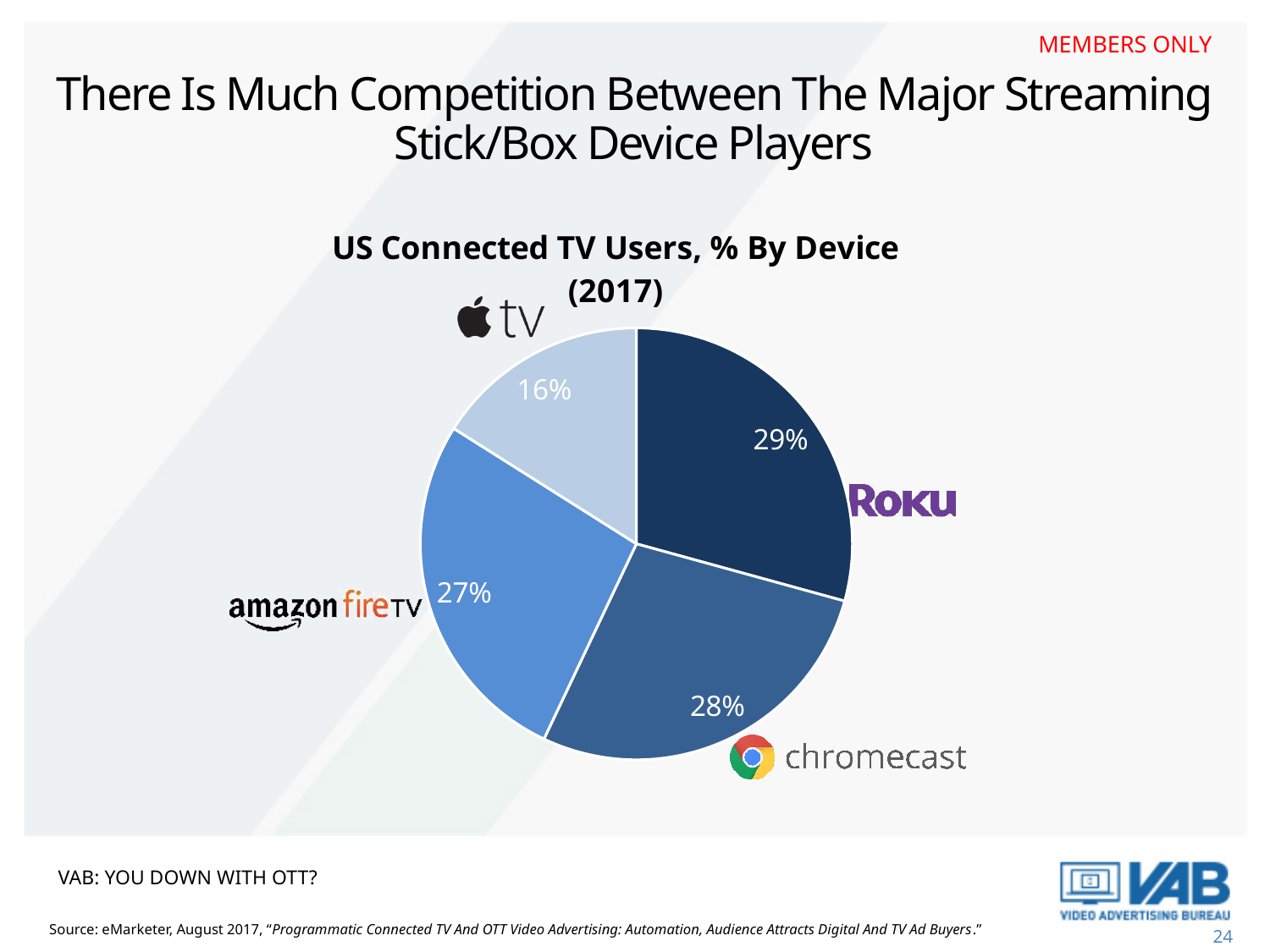
What share of US connected TV users does Apple TV have? 16% What share of US connected TV users does Amazon Fire TV have? 27% What share of US connected TV users does Roku have? 29% What kind of chart is shown on the slide? pie chart What is the title of the chart? US Connected TV Users, % By Device (2017) How many devices are shown in the pie chart? 4 Which device has the smallest share of US connected TV users? Apple TV Which device has the largest share of US connected TV users? Roku What share of US connected TV users does Chromecast have? 28% Which has a larger share, Amazon Fire TV or Apple TV? Amazon Fire TV What is the difference in share between Roku and Apple TV? 13% What is the difference in share between Chromecast and Amazon Fire TV? 1%